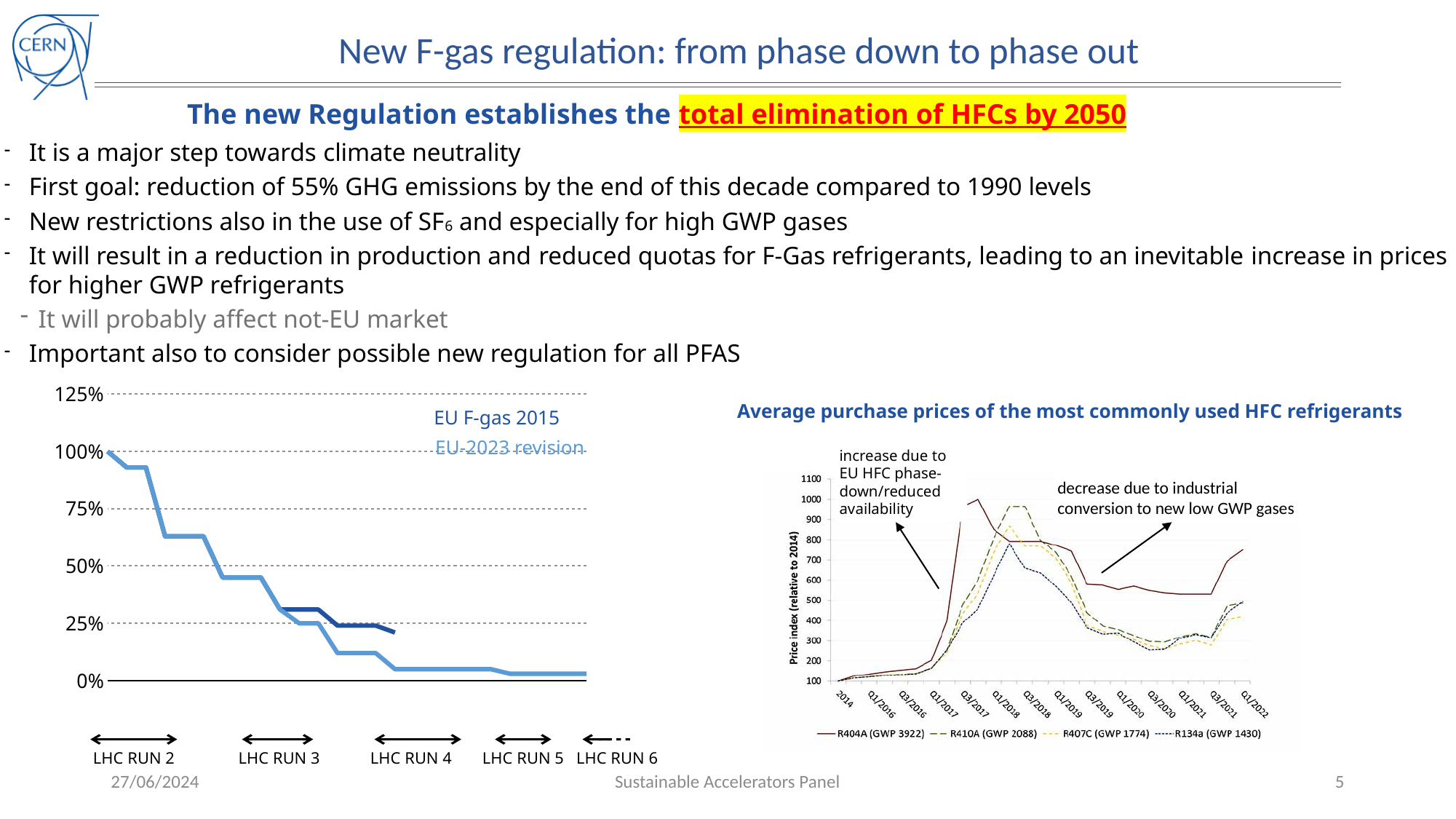
What kind of chart is the right chart of HFC refrigerant prices? line chart In the left chart, is the value of the EU F-gas 2015 line at the right edge greater or less than 25%? less What kind of chart is the left chart showing the EU F-gas phase-down? line chart In the right chart, is the price index of R134a at Q1/2022 greater or less than 600? less In the right chart, which is larger at Q1/2022: the price index of R404A or of R134a? R404A In the right chart, how many series does the legend list? 4 In the left chart, how many series does the legend list? 2 In the right chart, is the price index of R404A at Q3/2017 greater or less than 900? greater In the right chart, which refrigerant has the highest price index at Q3/2017? R404A (GWP 3922) In the left chart, do the values rise or fall along the x axis? fall In the left chart, what is the starting value of the EU F-gas 2015 line at the left edge? 100% What is the title of the right chart? Average purchase prices of the most commonly used HFC refrigerants